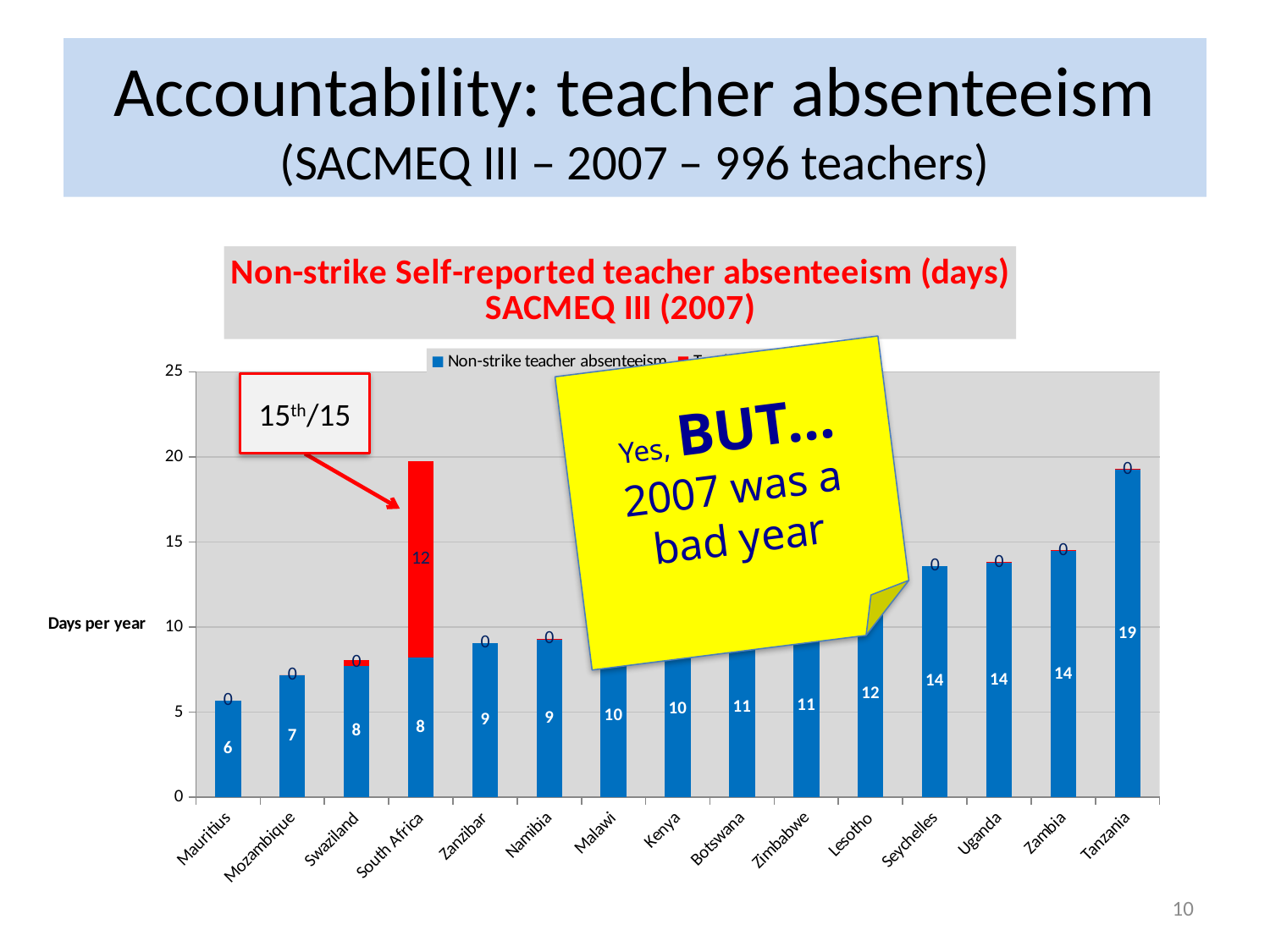
Which country has the highest non-strike teacher absenteeism? Tanzania What is the non-strike teacher absenteeism value for Mauritius? 6 What is the difference between the non-strike absenteeism values for Tanzania and Mauritius? 13 Which has a larger non-strike absenteeism value, Lesotho or Seychelles? Seychelles What is the total of the stacked bar for South Africa (blue plus red)? 20 What is the label on the vertical axis? Days per year Is the total bar height for Tanzania greater or less than 15? greater What is the non-strike teacher absenteeism value for Tanzania? 19 What kind of chart is shown on the slide? bar chart How many countries are shown on the x axis? 15 Which country has the lowest non-strike teacher absenteeism? Mauritius What is the value of the red segment for South Africa? 12